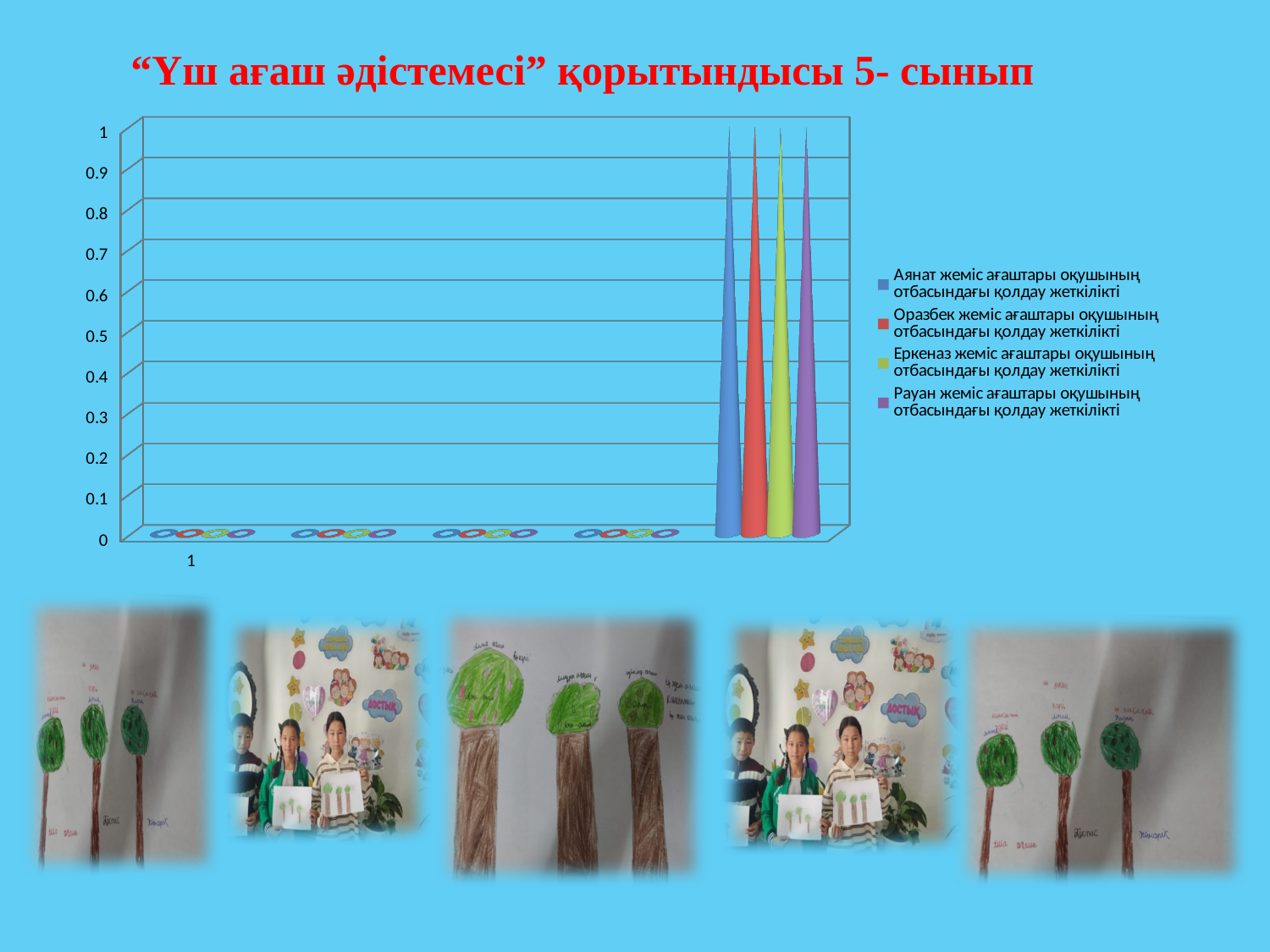
What value does the bar for "Аянат жеміс ағаштары оқушының отбасындағы қолдау жеткілікті" reach on the vertical axis? 1 How many series does the chart's legend list? 4 What value does the bar for "Рауан жеміс ағаштары оқушының отбасындағы қолдау жеткілікті" reach on the vertical axis? 1 Is the value for the series "Еркеназ жеміс ағаштары оқушының отбасындағы қолдау жеткілікті" greater or less than 0.8? greater Is the value for the series "Оразбек жеміс ағаштары оқушының отбасындағы қолдау жеткілікті" greater or less than 0.5? greater What kind of chart is shown on the slide? bar chart What is the highest value shown on the chart's vertical axis? 1 Is the value for the series "Рауан жеміс ағаштары оқушының отбасындағы қолдау жеткілікті" greater or less than 0.9? greater What is the title of the chart on the slide? “Үш ағаш әдістемесі” қорытындысы 5- сынып